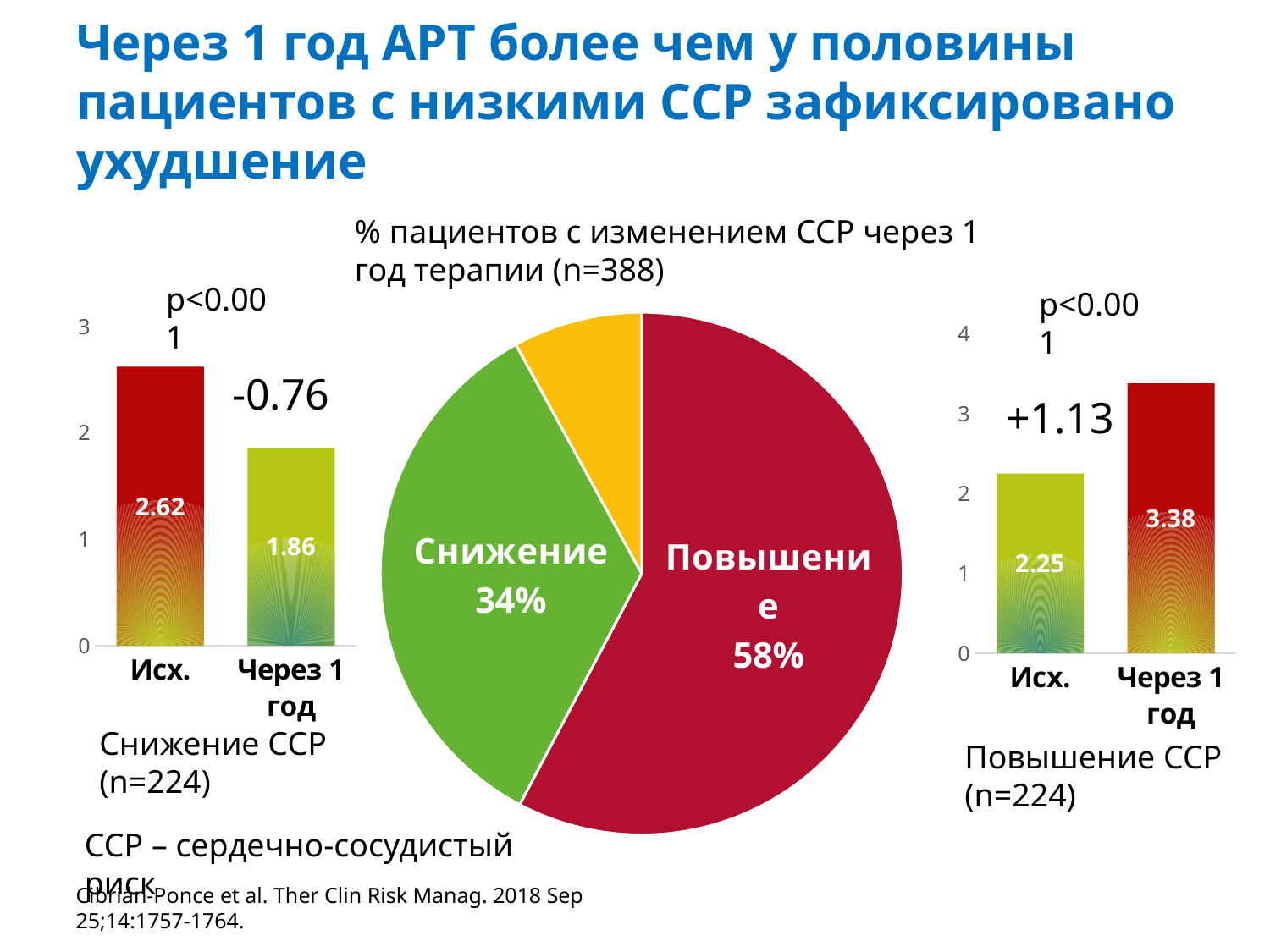
In the right bar chart (Повышение ССР), which category has the higher value, Исх. or Через 1 год? Через 1 год In the pie chart, what share of patients is labelled Снижение? 34% In the left bar chart (Снижение ССР), what is the difference between Исх. and Через 1 год? 0.76 In the left bar chart (Снижение ССР), which category has the lowest value? Через 1 год What kind of chart is the chart in the centre of the slide? Pie chart In the left bar chart (Снижение ССР), what is the value for Исх.? 2.62 In the right bar chart (Повышение ССР), what is the difference between Через 1 год and Исх.? 1.13 How many slices does the pie chart have? 3 In the right bar chart (Повышение ССР), what is the value for Исх.? 2.25 In the right bar chart (Повышение ССР), what is the value for Через 1 год? 3.38 In the pie chart, what share of patients is labelled Повышение? 58% In the left bar chart (Снижение ССР), what is the value for Через 1 год? 1.86